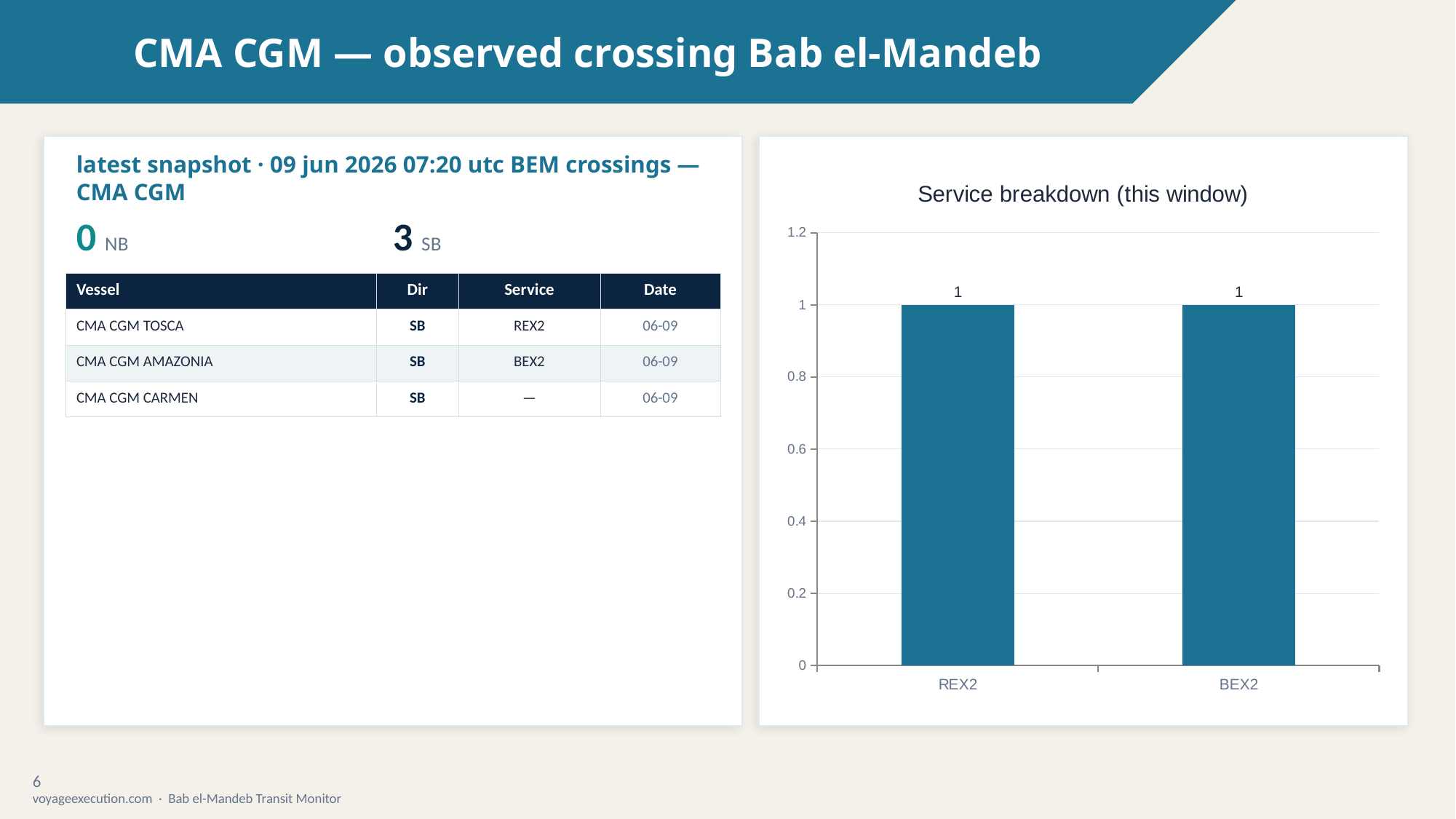
How many categories are shown on the x axis of the Service breakdown chart? 2 What kind of chart is the Service breakdown chart? bar chart What is the value for REX2 in the Service breakdown chart? 1 What is the highest tick value shown on the y axis of the Service breakdown chart? 1.2 What is the value for BEX2 in the Service breakdown chart? 1 What is the title of the chart on the right of the slide? Service breakdown (this window) What is the total of the values for REX2 and BEX2 in the Service breakdown chart? 2 What is the difference between the values for REX2 and BEX2 in the Service breakdown chart? 0 Is the value for BEX2 in the Service breakdown chart greater or less than 1.2? less Is the value for REX2 in the Service breakdown chart greater or less than 0.8? greater